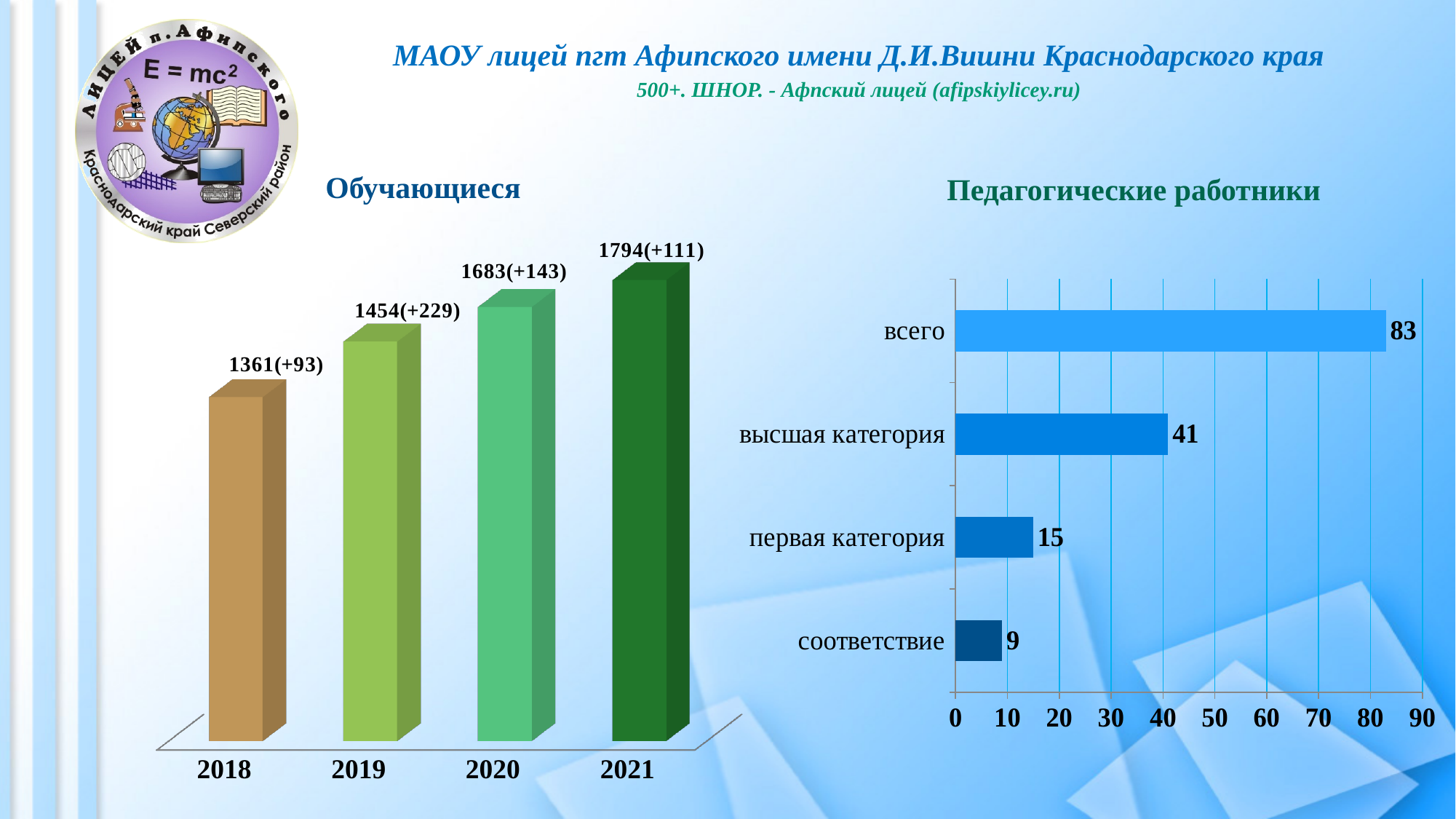
In the "Обучающиеся" chart, which year has the highest value? 2021 In the "Педагогические работники" chart, which is larger: "первая категория" or "соответствие"? первая категория In the "Педагогические работники" chart, which category has the lowest value? соответствие In the "Обучающиеся" chart, what data label is shown for 2021? 1794(+111) In the "Педагогические работники" chart, what is the value for "соответствие"? 9 In the "Педагогические работники" chart, what is the difference between "всего" and "высшая категория"? 42 In the "Педагогические работники" chart, what is the value for "высшая категория"? 41 In the "Обучающиеся" chart, how many years are shown? 4 In the "Обучающиеся" chart, do the values rise or fall from 2018 to 2021? rise What kind of chart is the "Педагогические работники" chart? bar chart In the "Обучающиеся" chart, which year has the lowest value? 2018 In the "Обучающиеся" chart, what data label is shown for 2018? 1361(+93)